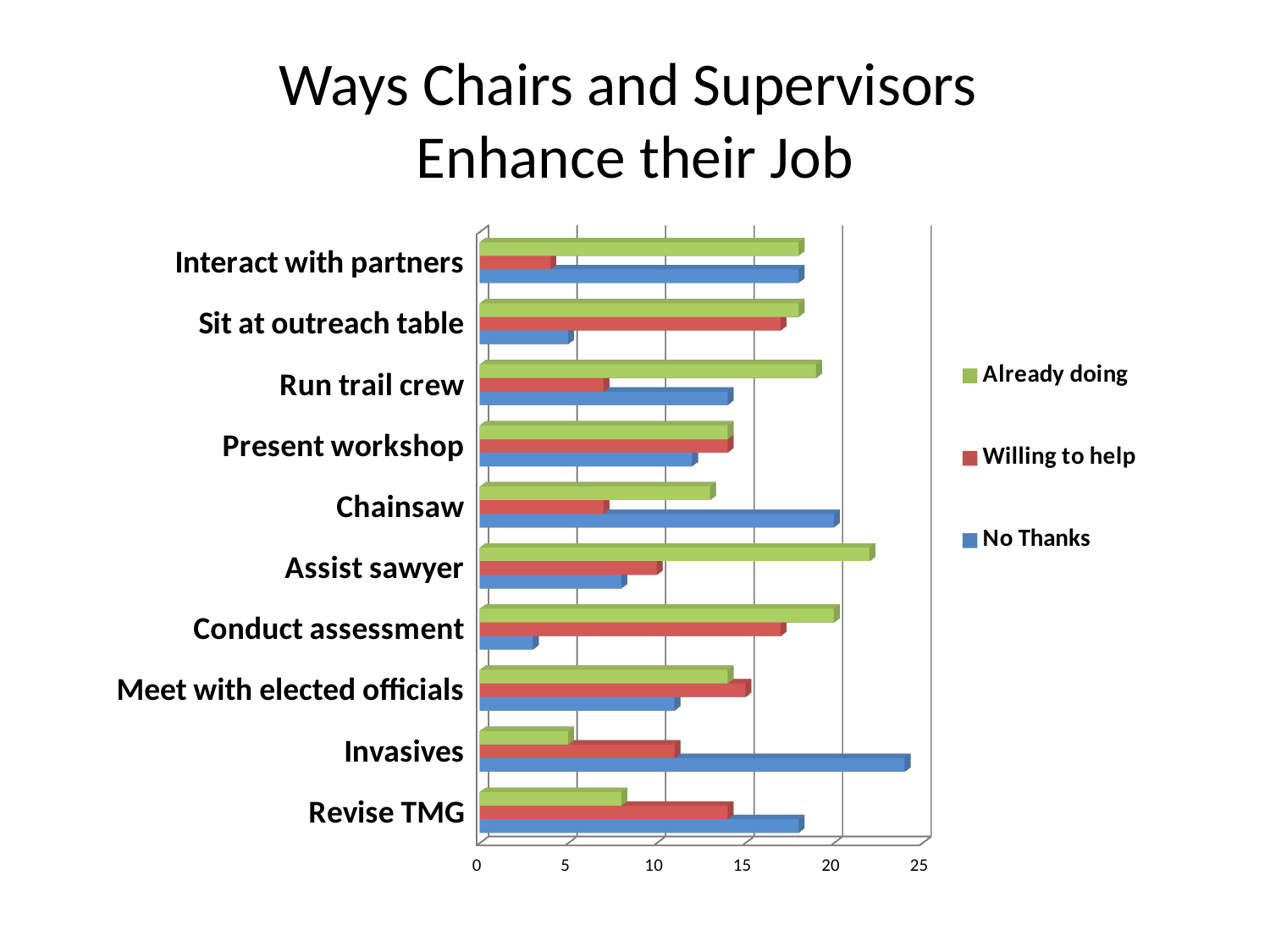
For Assist sawyer, which is larger: the "Already doing" value or the "Willing to help" value? Already doing What kind of chart is shown on the slide? bar chart Which category has the highest "No Thanks" value? Invasives Is the "No Thanks" value for Invasives greater or less than 20? greater For Chainsaw, which is larger: the "Already doing" value or the "No Thanks" value? No Thanks Which category has the lowest "Already doing" value? Invasives How many series does the chart's legend list? 3 Which category has the highest "Already doing" value? Assist sawyer Is the "Willing to help" value for Interact with partners greater or less than 5? less How many categories are listed on the vertical axis of the chart? 10 What is the title of the chart on the slide? Ways Chairs and Supervisors Enhance their Job Which category has the lowest "No Thanks" value? Conduct assessment